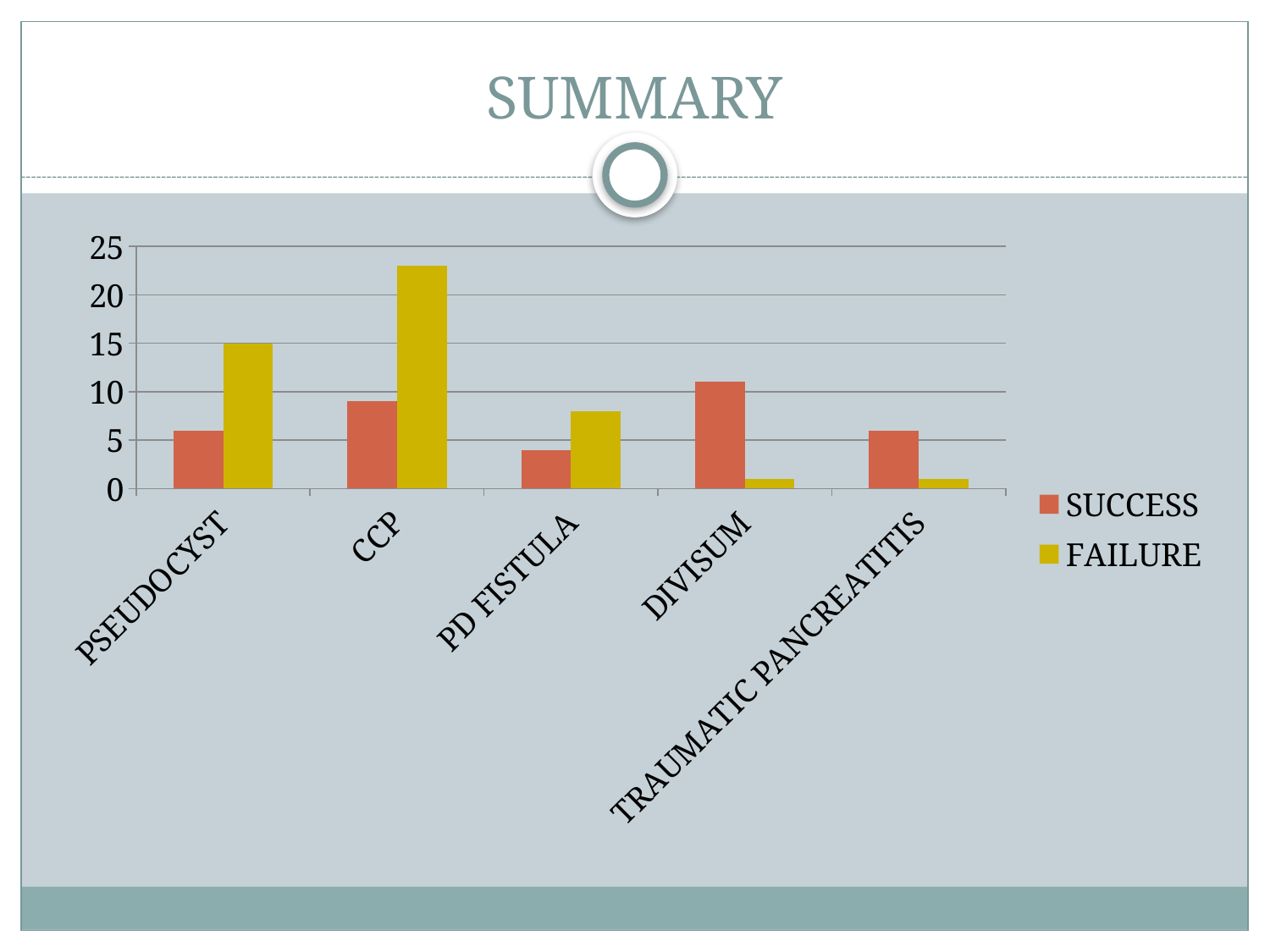
Which category has the highest FAILURE value? CCP Which category has the highest SUCCESS value? DIVISUM What are the two entries in the chart's legend? SUCCESS and FAILURE How many categories are shown on the x axis? 5 Is the SUCCESS value for DIVISUM greater or less than 10? greater How many series does the legend list? 2 Is the SUCCESS value for PD FISTULA greater or less than 5? less For PSEUDOCYST, which is larger, SUCCESS or FAILURE? FAILURE Is the FAILURE value for CCP greater or less than 20? greater For DIVISUM, which is larger, SUCCESS or FAILURE? SUCCESS What kind of chart is shown on the slide? bar chart Which category has the lowest SUCCESS value? PD FISTULA